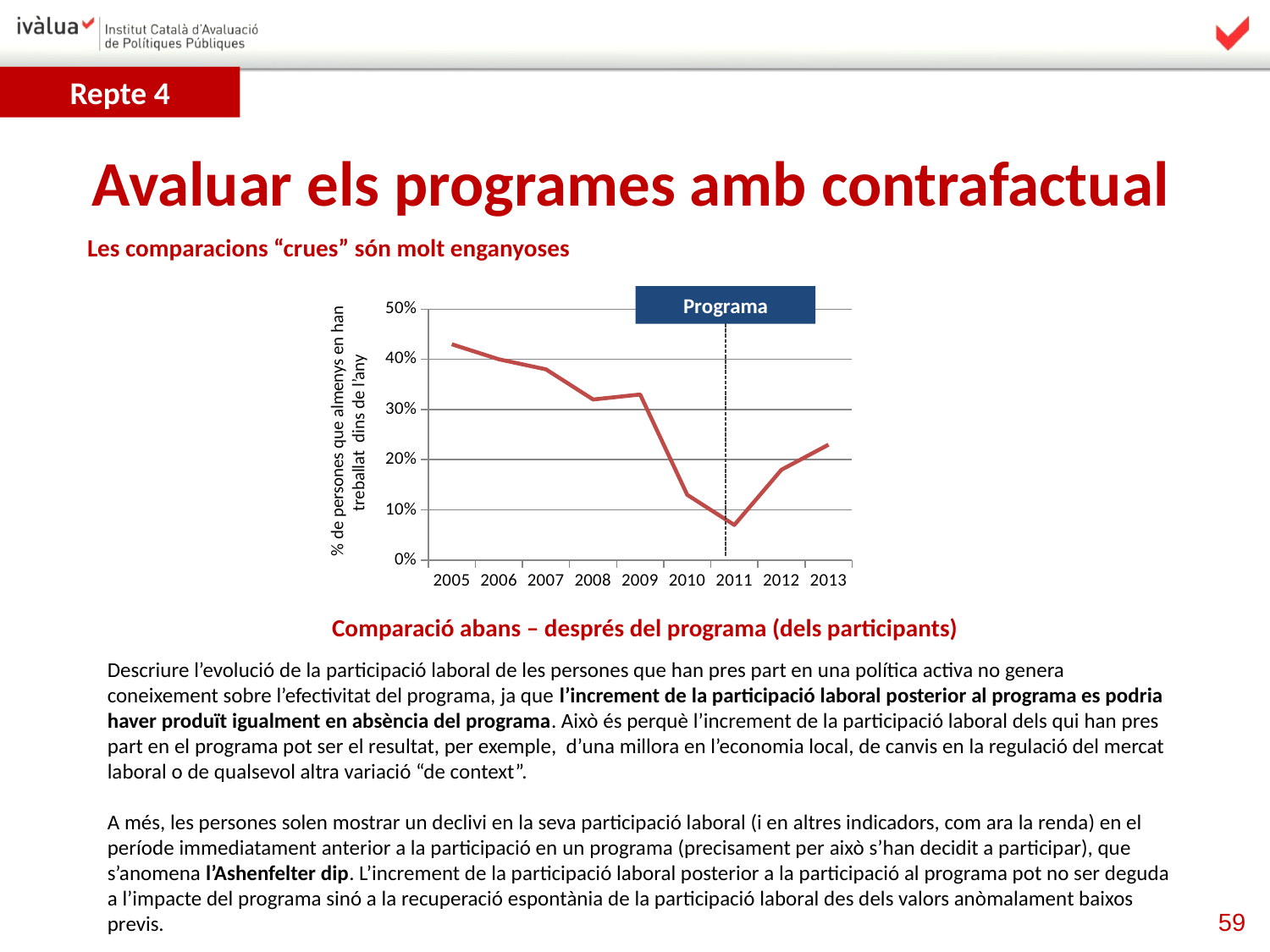
Which year has the lowest value in the chart? 2011 Which is larger, the value for 2005 or the value for 2013? 2005 How many years are plotted along the x axis of the chart? 9 Is the value for 2008 greater or less than 30%? greater Do the values rise or fall from 2005 to 2011? fall Is the value for 2013 greater or less than 30%? less Do the values rise or fall from 2011 to 2013? rise What label is shown in the box above the dashed vertical line in the chart? Programa Which year has the highest value in the chart? 2005 Is the value for 2011 greater or less than 10%? less What kind of chart is shown on the slide? line chart